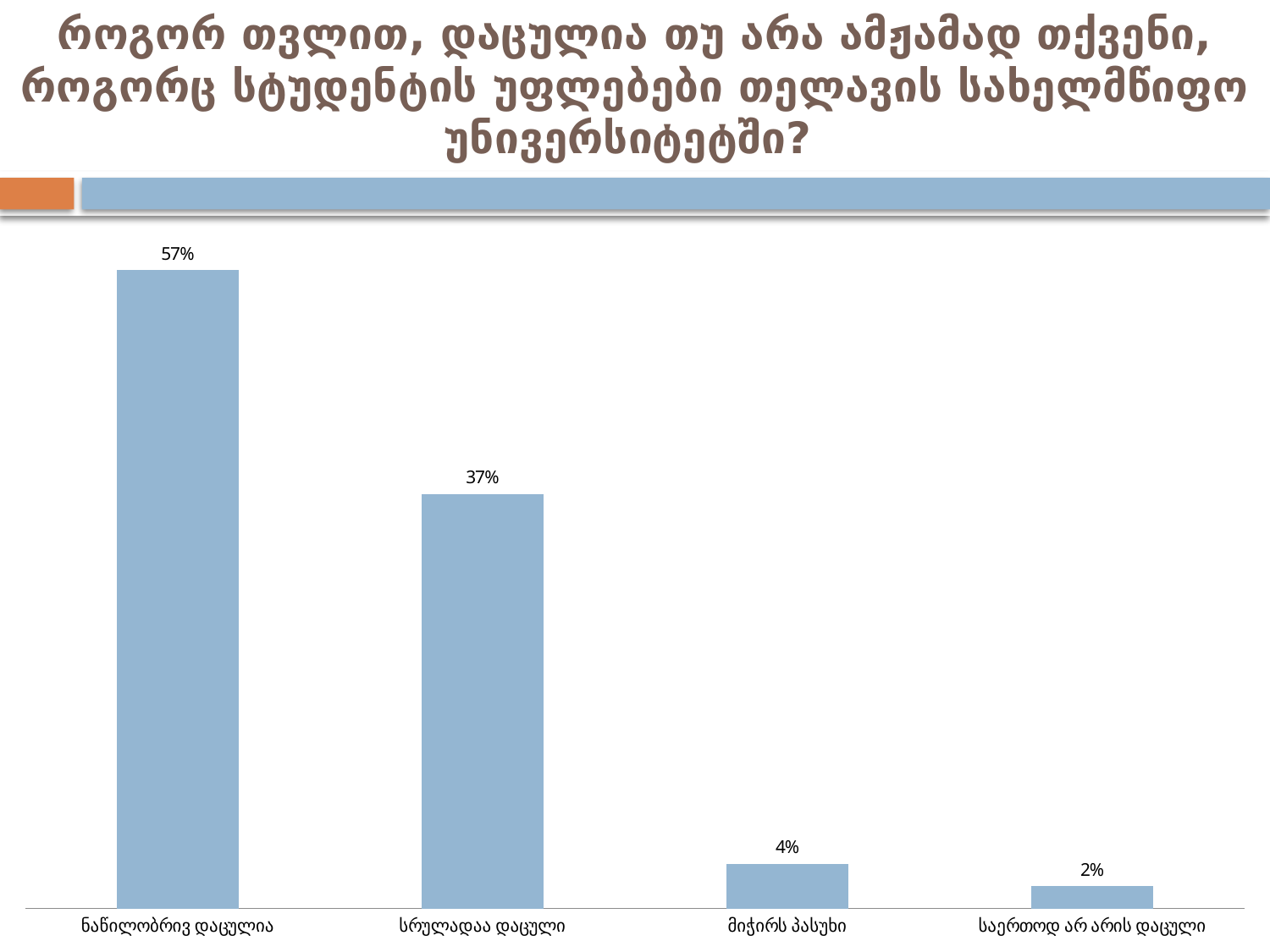
What is the difference between the values for "ნაწილობრივ დაცულია" and "სრულადაა დაცული"? 20% What kind of chart is shown on the slide? Bar chart What value is shown for the category "სრულადაა დაცული"? 37% Do the values rise or fall from left to right across the categories? Fall Which category has the lowest value? საერთოდ არ არის დაცული Which is larger: the value for "სრულადაა დაცული" or the value for "მიჭირს პასუხი"? სრულადაა დაცული What value is shown for the category "საერთოდ არ არის დაცული"? 2% How many categories are shown in the chart? 4 What value is shown for the category "ნაწილობრივ დაცულია"? 57% What is the difference between the values for "მიჭირს პასუხი" and "საერთოდ არ არის დაცული"? 2% Which category has the highest value? ნაწილობრივ დაცულია What value is shown for the category "მიჭირს პასუხი"? 4%